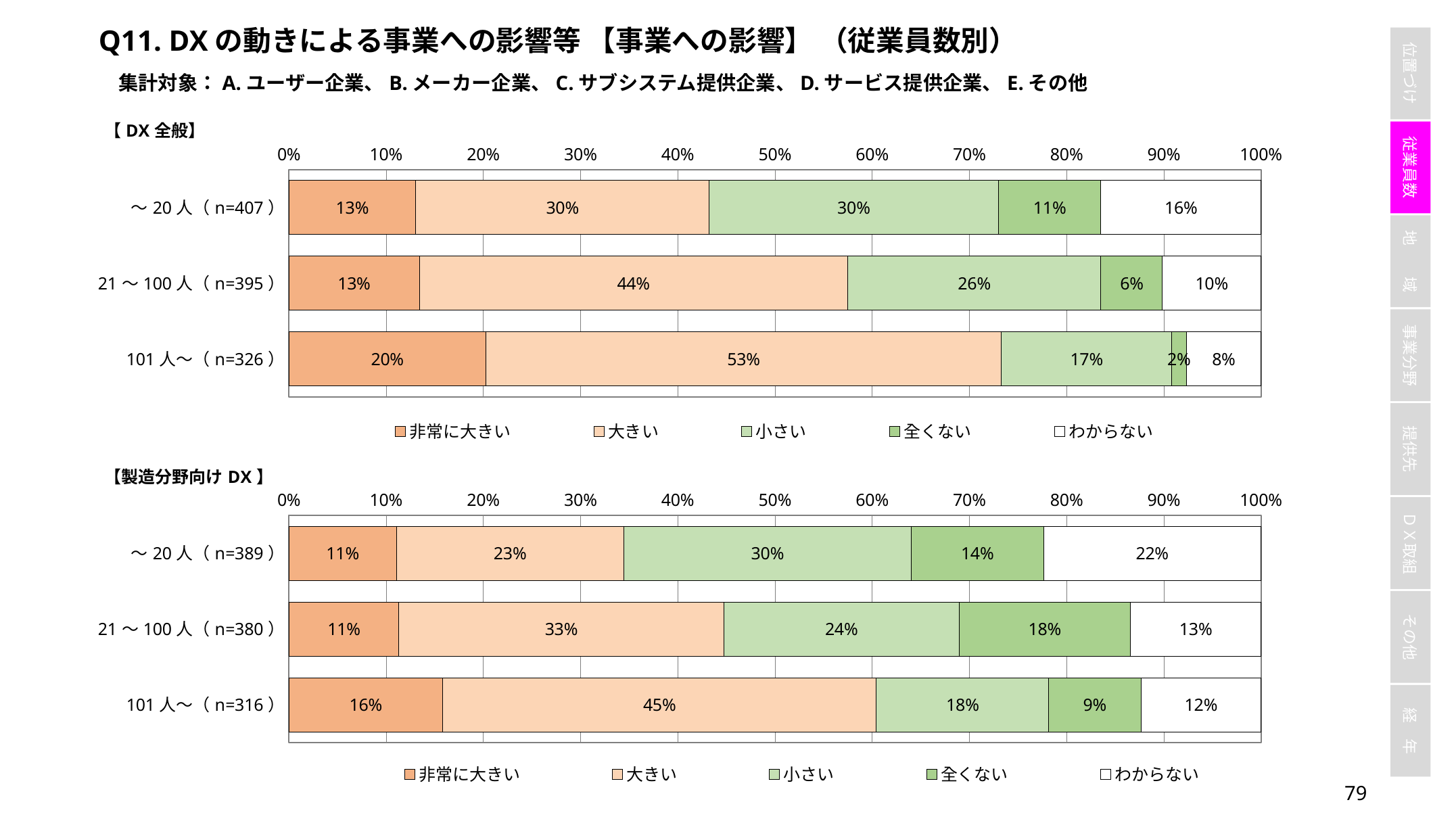
In the 【製造分野向けDX】 chart, which is larger for 101人～（n=316）: 小さい or 全くない? 小さい In the 【DX全般】 chart, what is the difference between the 大きい values for 101人～（n=326） and ～20人（n=407）? 23% In the 【製造分野向けDX】 chart, which category has the highest value for わからない? ～20人（n=389） In the 【製造分野向けDX】 chart, what is the value of 全くない for 21～100人（n=380）? 18% In the 【DX全般】 chart, which category has the lowest value for 全くない? 101人～（n=326） In the 【DX全般】 chart, what is the value of わからない for ～20人（n=407）? 16% How many series does the legend of the 【製造分野向けDX】 chart list? 5 What kind of chart is the 【DX全般】 chart? Stacked bar chart In the 【DX全般】 chart, what is the value of 大きい for 21～100人（n=395）? 44% In the 【DX全般】 chart, which category has the highest value for 非常に大きい? 101人～（n=326） How many categories are shown in the 【DX全般】 chart? 3 In the 【製造分野向けDX】 chart, what is the difference between the 非常に大きい values for 101人～（n=316） and ～20人（n=389）? 5%